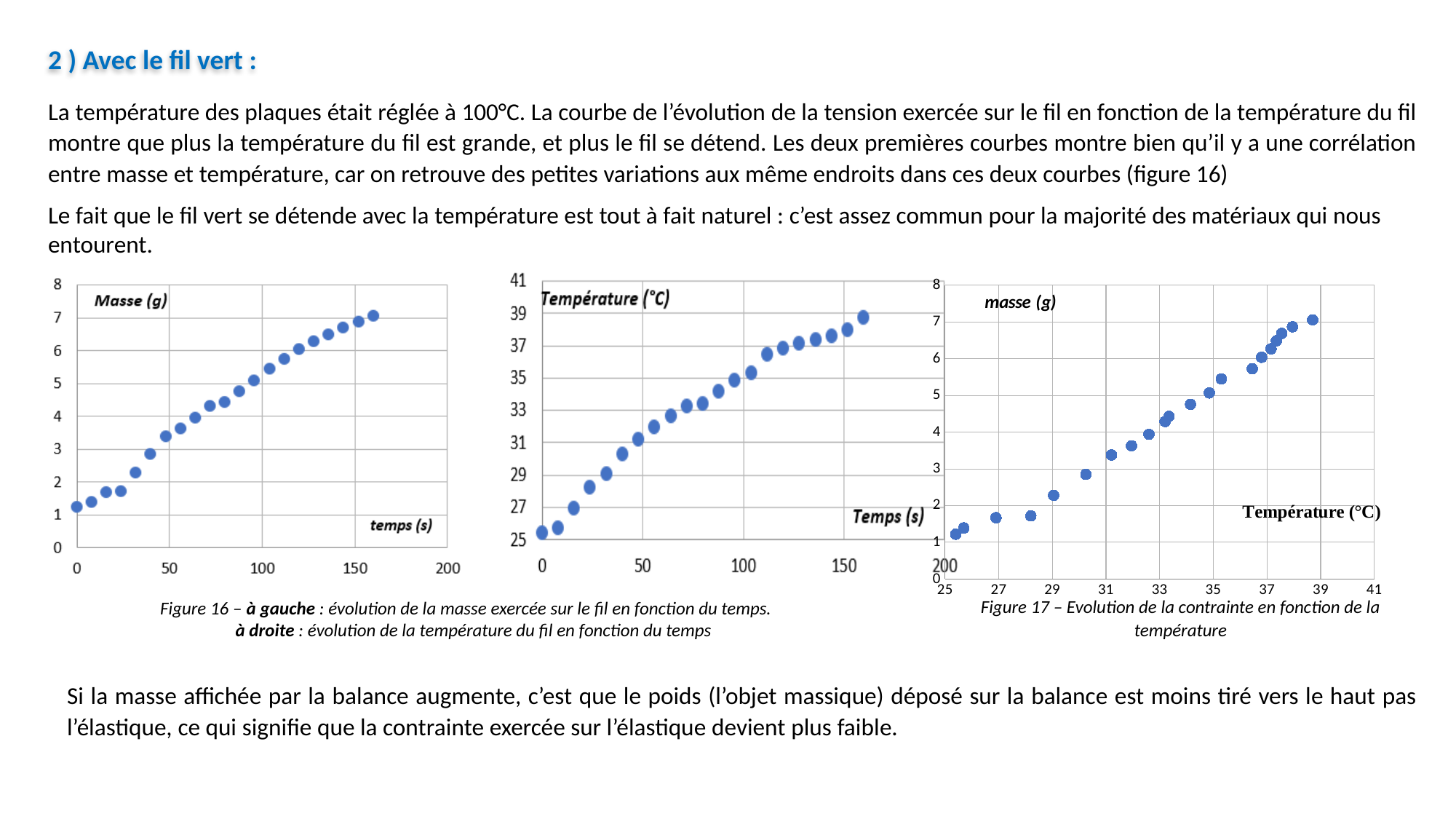
What is the x-axis label of the middle chart of Figure 16? Temps (s) In the left chart of Figure 16, is the mass value at time 0 s greater or less than 2? less In the middle chart of Figure 16 (Température vs Temps), do the temperature values rise or fall as time increases? rise What is the y-axis label of the left chart of Figure 16? Masse (g) In the middle chart of Figure 16, is the temperature at time 0 s greater or less than 27? less In Figure 17, is the mass value at a temperature of 39 °C greater or less than 6? greater In Figure 17 (masse vs Température), do the mass values rise or fall as temperature increases? rise In the left chart of Figure 16, do the mass values rise or fall as time increases? rise What kind of chart is the left chart of Figure 16 (Masse vs temps)? scatter chart